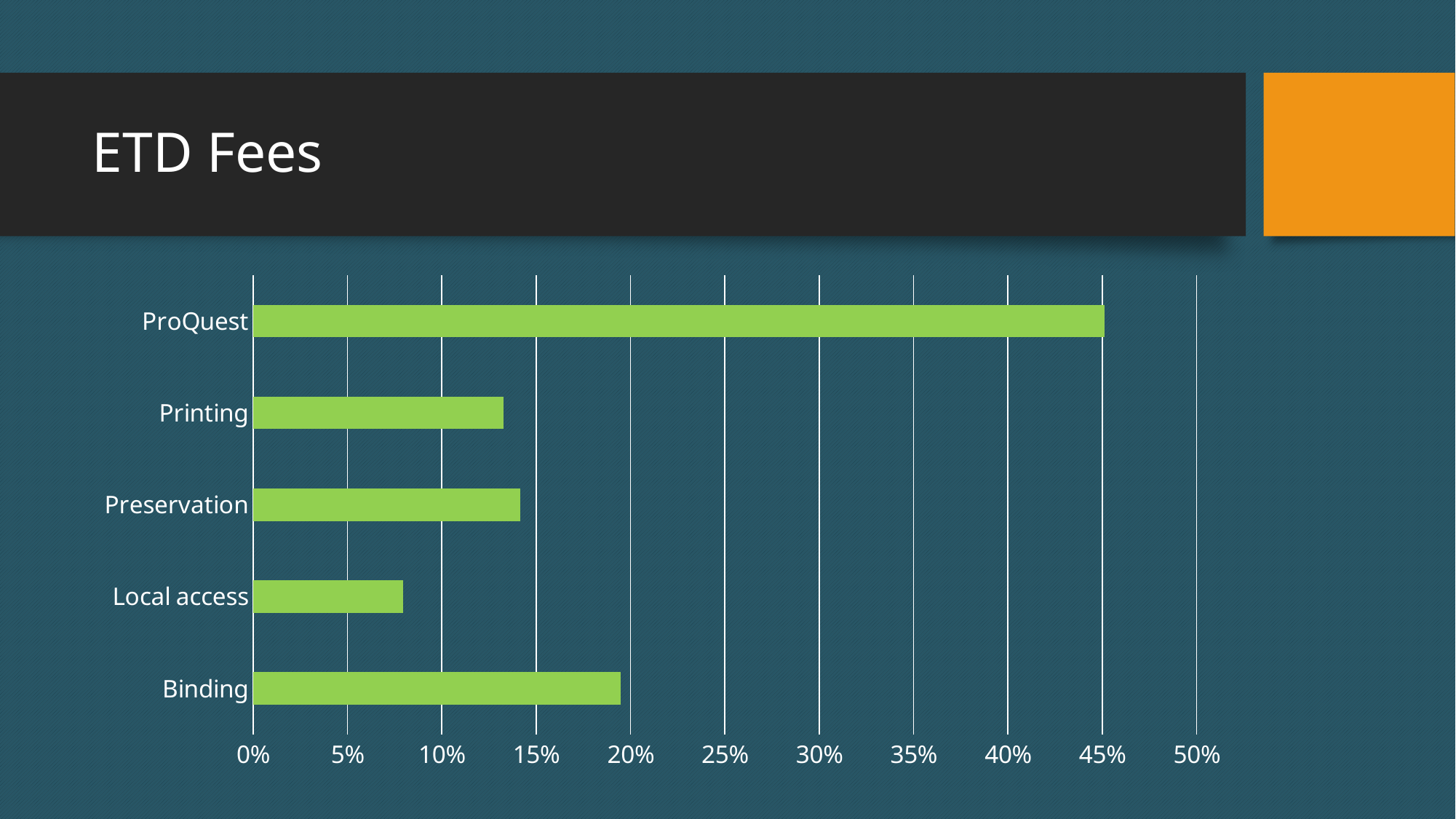
Is the value for Printing greater or less than 10%? greater Is the value for Preservation greater or less than 15%? less Which has a larger value, Binding or Preservation? Binding Is the value for Binding greater or less than 20%? less How many categories are plotted in the chart? 5 What kind of chart is shown on the slide? bar chart Which category has the lowest value? Local access Which has a larger value, ProQuest or Binding? ProQuest Which category has the highest value? ProQuest What is the title of the slide containing the chart? ETD Fees